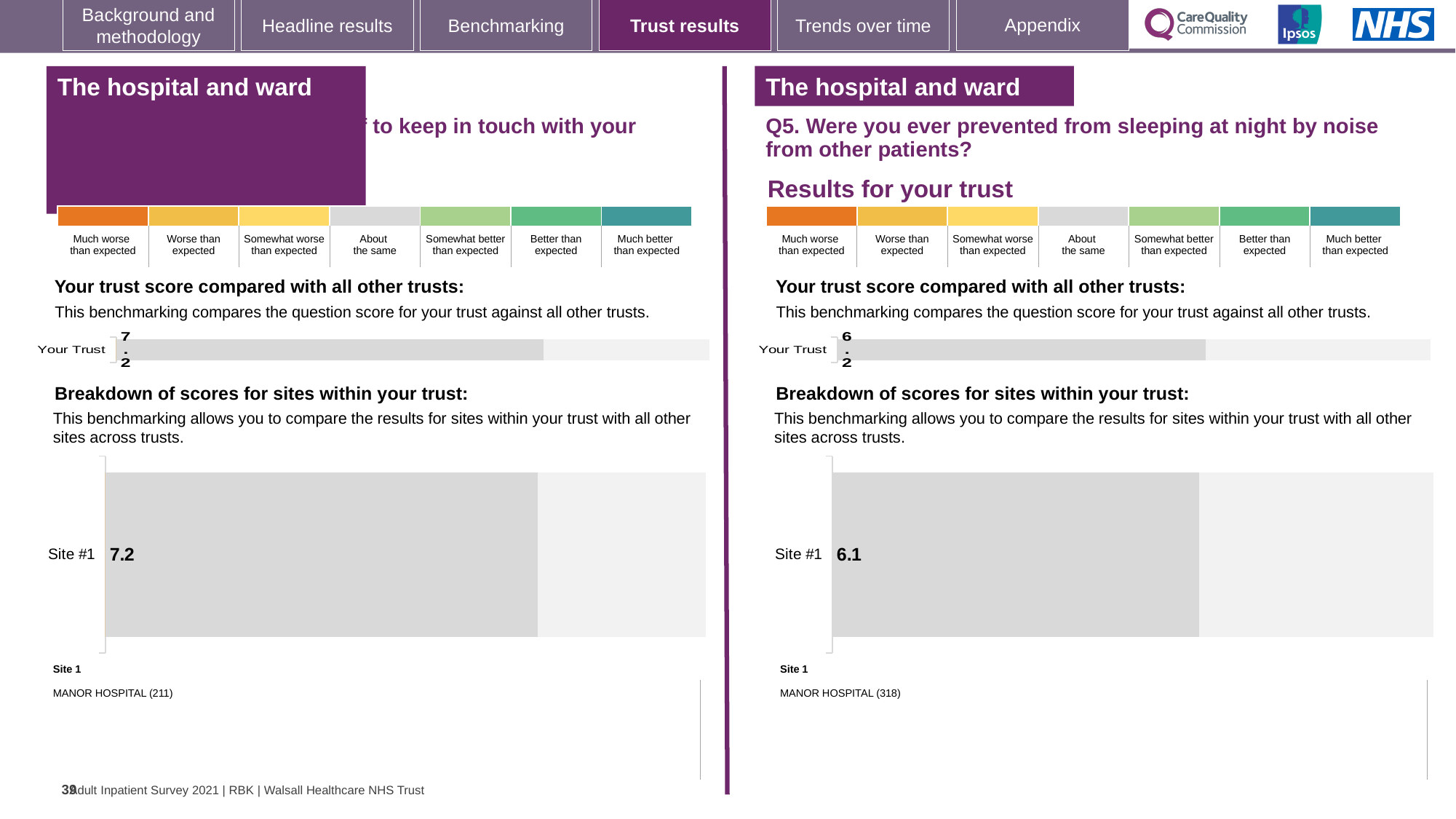
Which is larger: the Your Trust score on the left-hand panel or the Your Trust score on the right-hand panel (Q5)? Left-hand panel (7.2) On the right-hand panel (Q5, prevented from sleeping at night by noise from other patients), what is the score shown for Your Trust? 6.2 On the left-hand panel, which site name is listed as Site 1 below the breakdown chart? MANOR HOSPITAL (211) How many sites are shown in the breakdown of scores chart on the right-hand panel (Q5)? 1 What is the difference between the Site #1 score on the left-hand panel (7.2) and the Site #1 score on the right-hand panel (6.1)? 1.1 Which is larger: the Site #1 score on the left-hand panel or the Site #1 score on the right-hand panel (Q5)? Left-hand panel (7.2) On the right-hand panel (Q5), what is the difference between the Your Trust score and the Site #1 score? 0.1 On the left-hand panel, what score is shown for Site #1 in the breakdown of scores for sites within your trust? 7.2 On the right-hand panel (Q5), what score is shown for Site #1 in the breakdown of scores for sites within your trust? 6.1 On the left-hand panel, what is the score shown for Your Trust in the 'Your trust score compared with all other trusts' chart? 7.2 What type of chart is used to show the Site #1 score on the left-hand panel? Bar chart On the right-hand panel (Q5), which site name is listed as Site 1 below the breakdown chart? MANOR HOSPITAL (318)